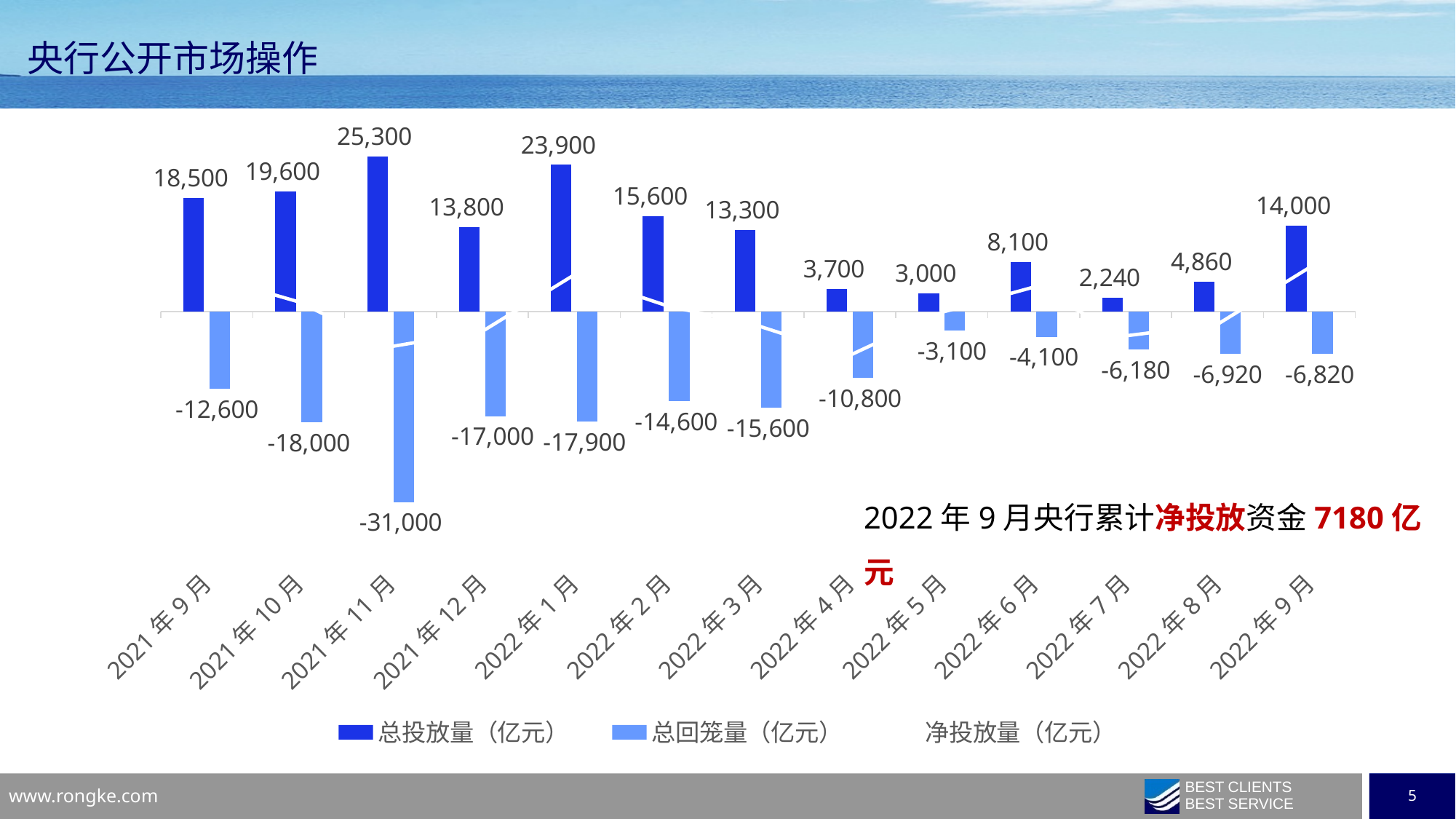
How many series does the legend list? 3 What is the 总回笼量（亿元） value for 2022年1月? -17,900 Which month has the lowest 总投放量（亿元）? 2022年7月 What is the title of the slide? 央行公开市场操作 What kind of chart is shown on the slide? Bar chart What is the 总投放量（亿元） value for 2021年11月? 25,300 What is the difference between the 总投放量（亿元） for 2022年9月 and 2022年8月? 9,140 Which month has the highest 总投放量（亿元）? 2021年11月 Which month has the lowest (most negative) 总回笼量（亿元）? 2021年11月 How many months are shown on the x axis of the chart? 13 What is the 总回笼量（亿元） value for 2022年5月? -3,100 Which is larger, the 总投放量（亿元） for 2021年10月 or for 2022年2月? 2021年10月